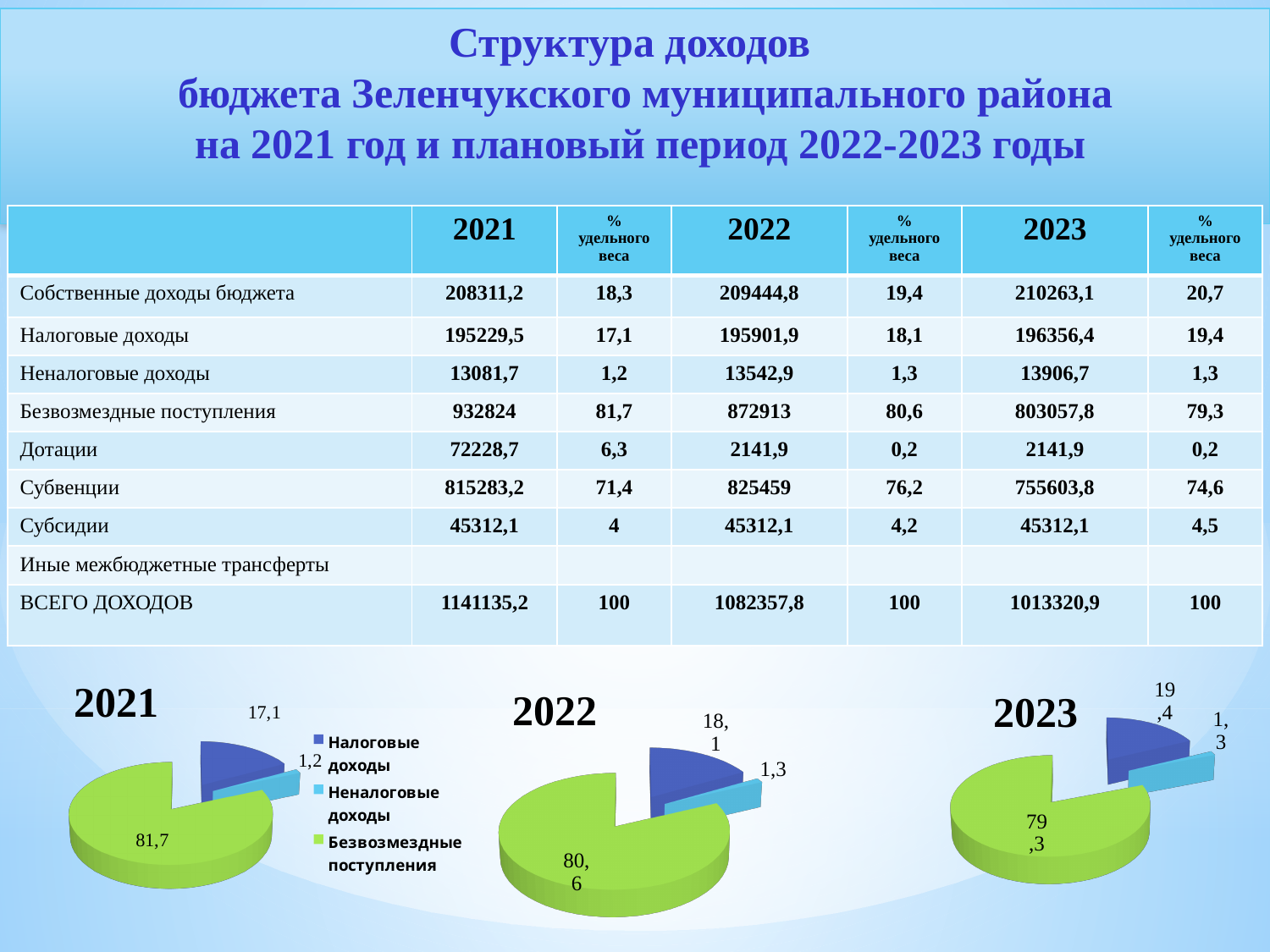
How many slices does the 2022 pie chart have? 3 In the 2023 pie chart, what is the value shown for Налоговые доходы? 19,4 What type of chart is used for the 2023 chart? Pie chart In the 2022 pie chart, what is the difference between the values for Безвозмездные поступления and Налоговые доходы? 62,5 In the legend next to the 2021 pie chart, which category is shown in green? Безвозмездные поступления In the 2021 pie chart, which category has the smallest slice? Неналоговые доходы In the 2021 pie chart, what is the value shown for Безвозмездные поступления? 81,7 In the 2022 pie chart, what is the value shown for Налоговые доходы? 18,1 How many entries does the legend next to the 2021 pie chart list? 3 In the 2023 pie chart, what is the value shown for Неналоговые доходы? 1,3 In the 2021 pie chart, which is larger: Налоговые доходы or Неналоговые доходы? Налоговые доходы In the 2023 pie chart, which category has the largest slice? Безвозмездные поступления